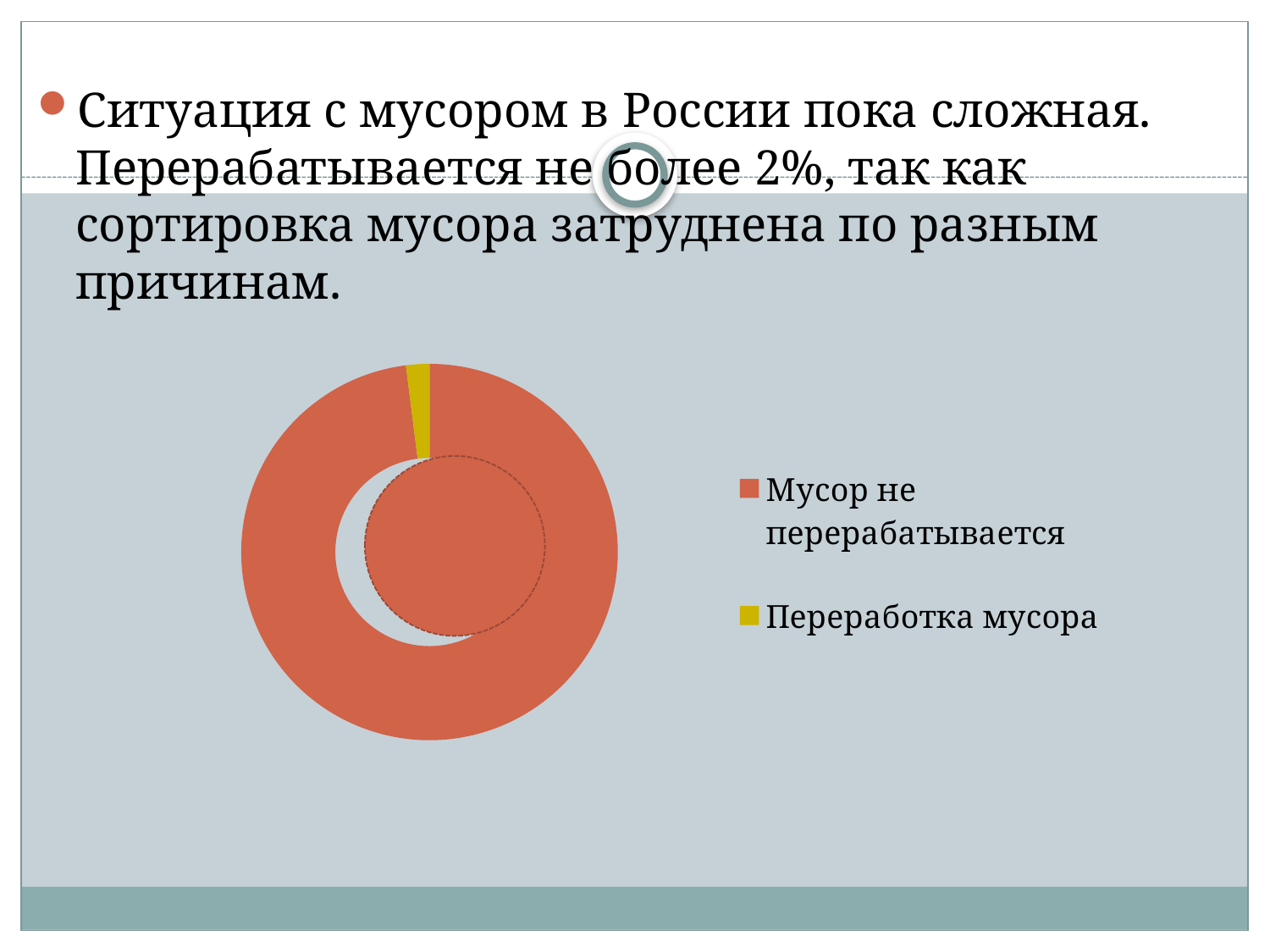
What colour is the slice for "Мусор не перерабатывается"? red How many entries does the chart legend list? 2 What colour is the slice for "Переработка мусора"? yellow Which slice is larger: "Мусор не перерабатывается" or "Переработка мусора"? Мусор не перерабатывается Which category has the largest slice in the chart? Мусор не перерабатывается How many slices does the doughnut chart have? 2 Which category has the smallest slice in the chart? Переработка мусора What kind of chart is shown on the slide? doughnut chart